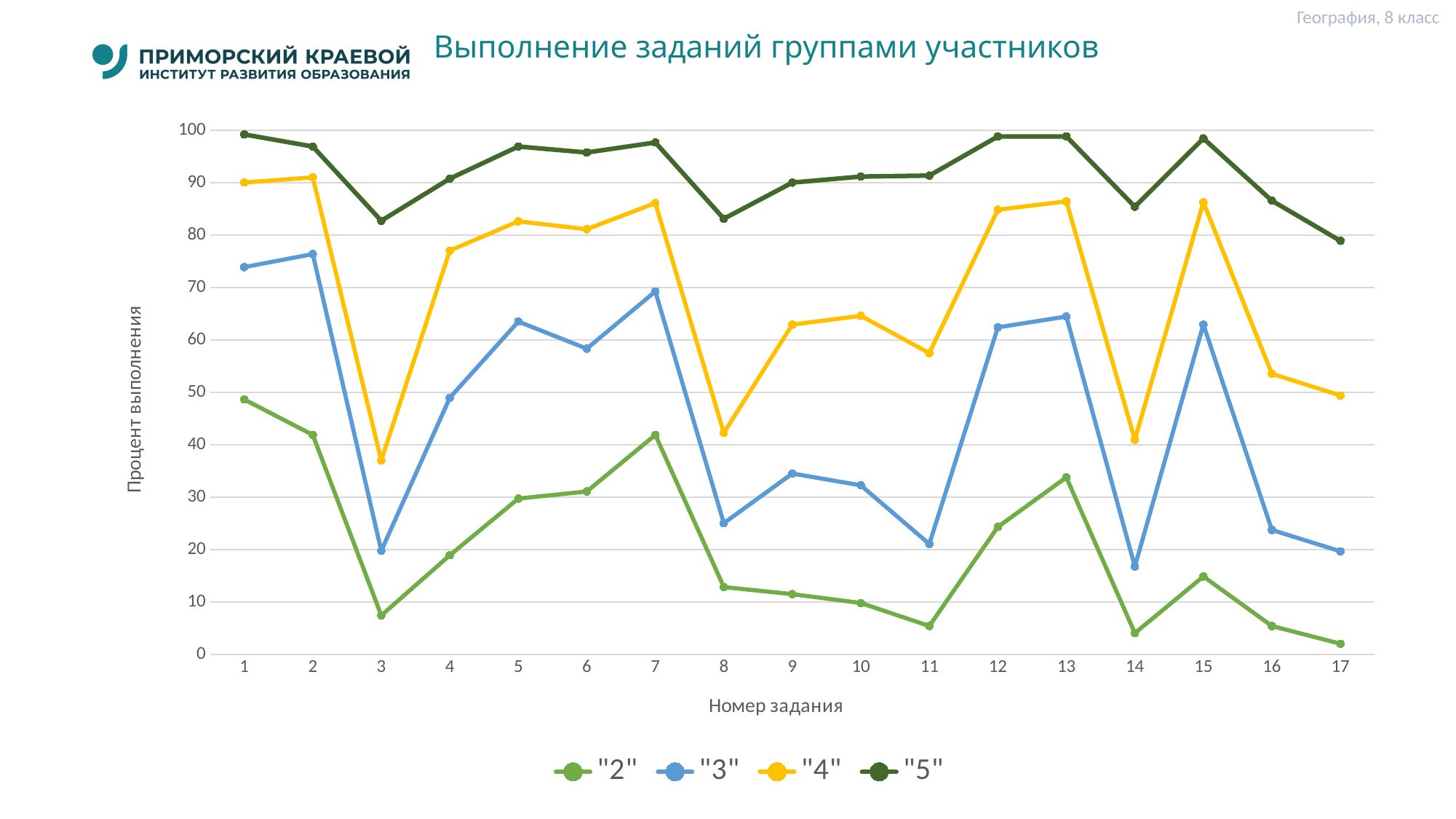
What is the title of the x axis? Номер задания Is the value for series "3" at task 14 greater or less than 20? less At task 15, which series has the larger value, "4" or "3"? "4" For series "2", at which task number is the value highest? 1 Is the value for series "4" at task 8 greater or less than 50? less What kind of chart is shown on the slide? line chart How many task numbers are plotted along the x axis? 17 For series "5", at which task number is the value lowest? 17 How many series does the legend list? 4 Is the value for series "2" at task 3 greater or less than 10? less What is the title of the y axis? Процент выполнения